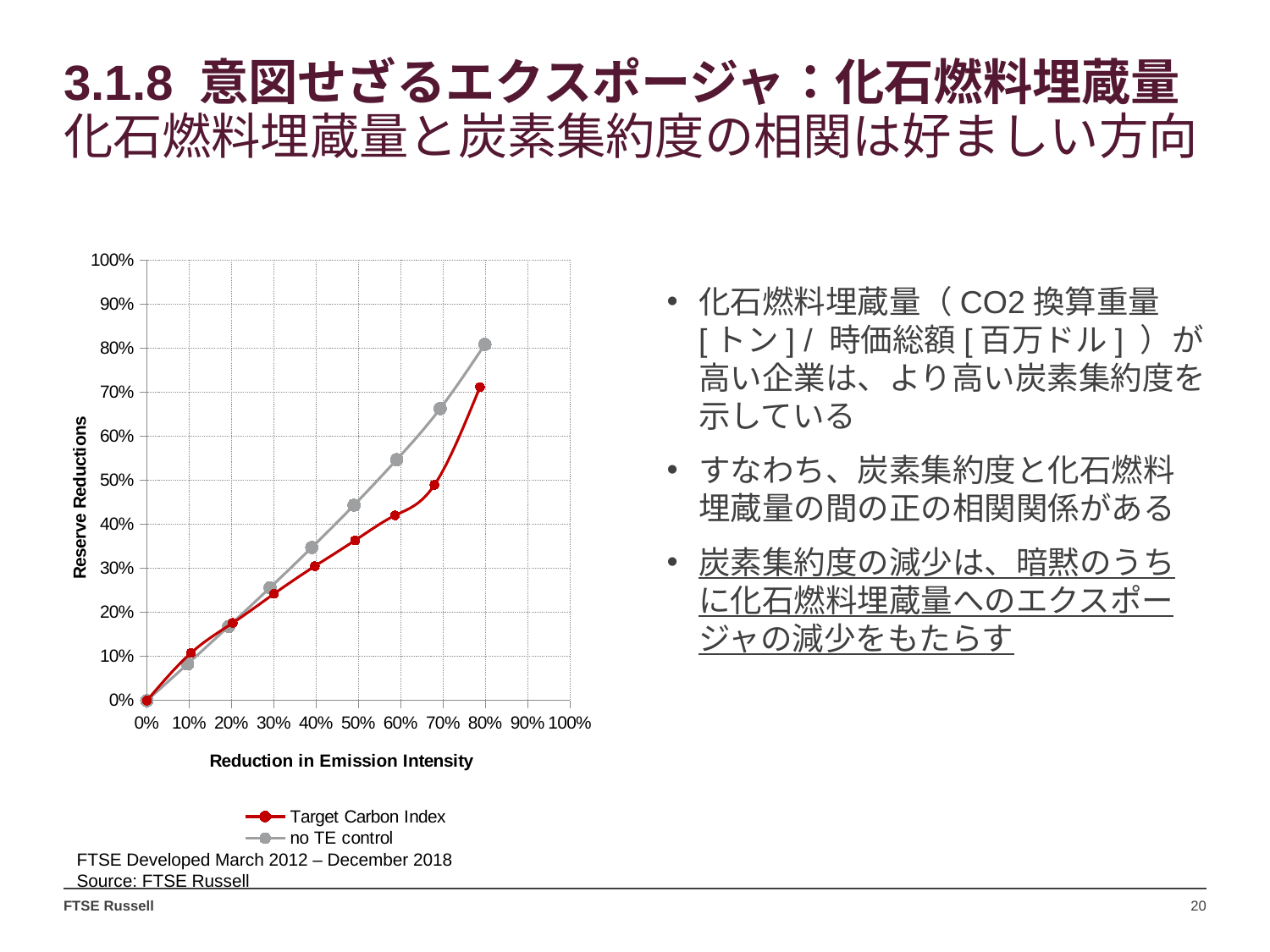
What are the two series named in the chart legend? Target Carbon Index; no TE control What is the title of the chart's vertical axis? Reserve Reductions Is the Reserve Reductions value for the no TE control series at 60% Reduction in Emission Intensity greater or less than 50%? greater How many series does the chart legend list? 2 At 60% Reduction in Emission Intensity, which series shows the higher Reserve Reductions value? no TE control At 80% Reduction in Emission Intensity, which series shows the higher Reserve Reductions value? no TE control Is the Reserve Reductions value for the Target Carbon Index series at 40% Reduction in Emission Intensity greater or less than 40%? less Do the values of the Target Carbon Index series rise or fall as Reduction in Emission Intensity increases? rise Is the Reserve Reductions value for the Target Carbon Index series at 60% Reduction in Emission Intensity greater or less than 50%? less Which series reaches the highest Reserve Reductions value on the chart? no TE control What kind of chart is shown on the slide? line chart